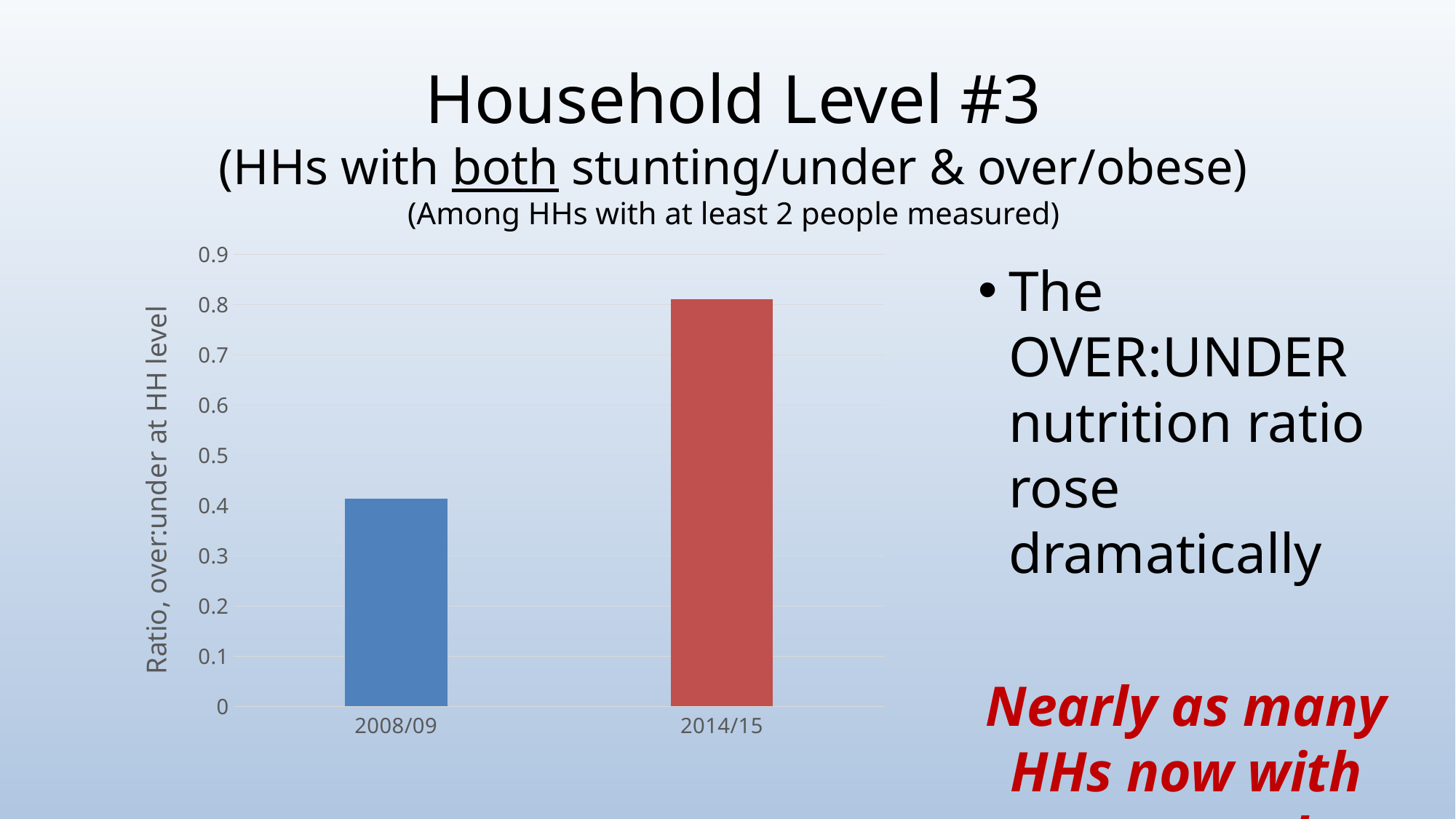
Which category has the highest ratio in the chart? 2014/15 How many bars (categories) does the chart show? 2 Is the value for 2014/15 greater or less than 0.7? greater Which category has the lowest ratio in the chart? 2008/09 Is the value for 2008/09 greater or less than 0.3? greater What kind of chart is shown on the slide? bar chart What colour is the bar for 2014/15? red Which is larger, the ratio for 2008/09 or the ratio for 2014/15? 2014/15 What is the label on the vertical axis of the chart? Ratio, over:under at HH level Is the value for 2008/09 greater or less than 0.5? less Does the ratio rise or fall from 2008/09 to 2014/15? rise